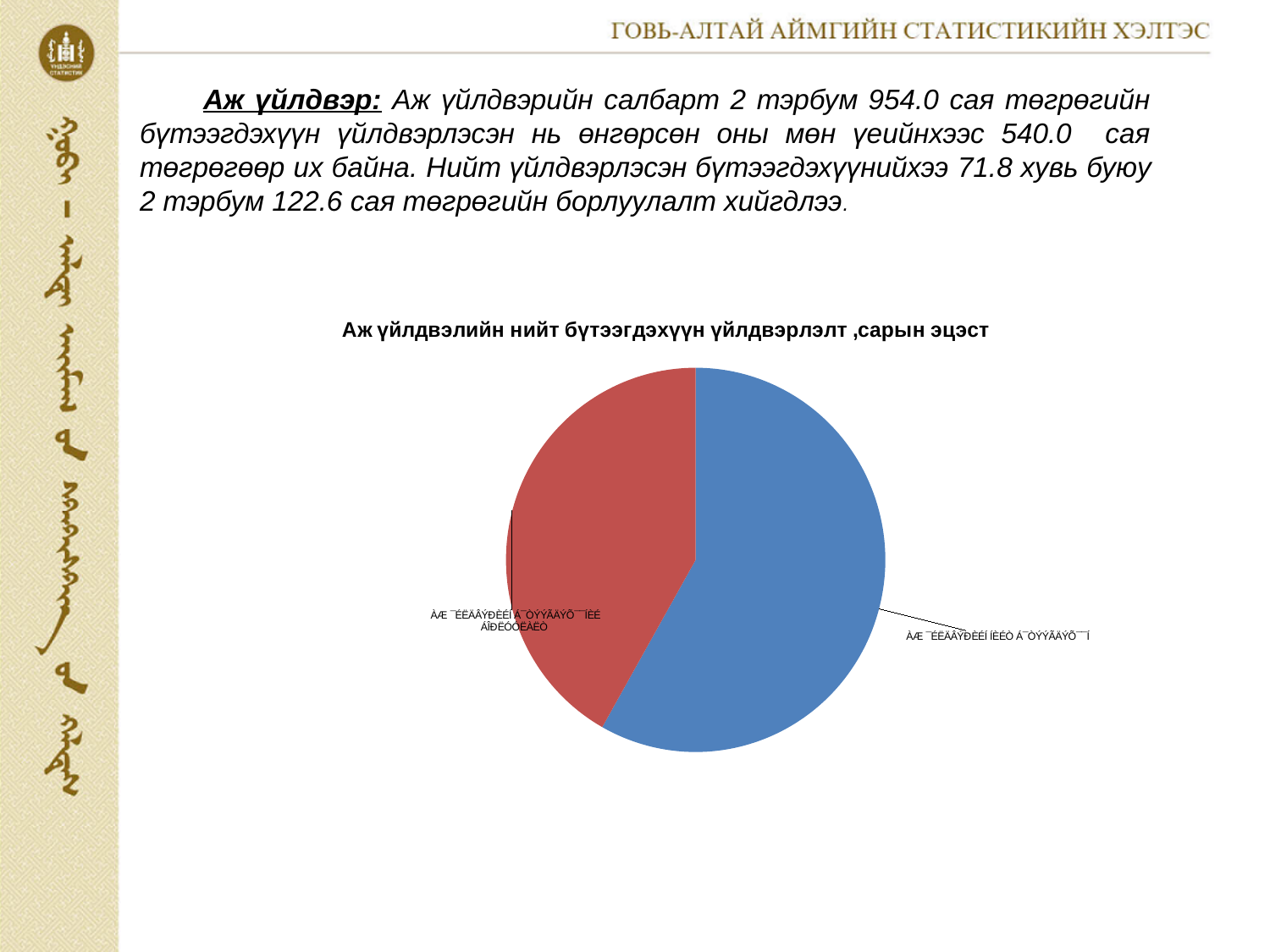
Which colour slice takes up the smallest share of the pie chart? red Which slice of the pie chart is larger, the blue one or the red one? the blue one What is the title of the pie chart? Аж үйлдвэлийн нийт бүтээгдэхүүн үйлдвэрлэлт ,сарын эцэст What two colours are used for the slices of the pie chart? blue and red How many slices does the pie chart have? 2 What kind of chart is shown on the slide? pie chart Does the blue slice represent more or less than half of the pie? more Which colour slice takes up the largest share of the pie chart? blue